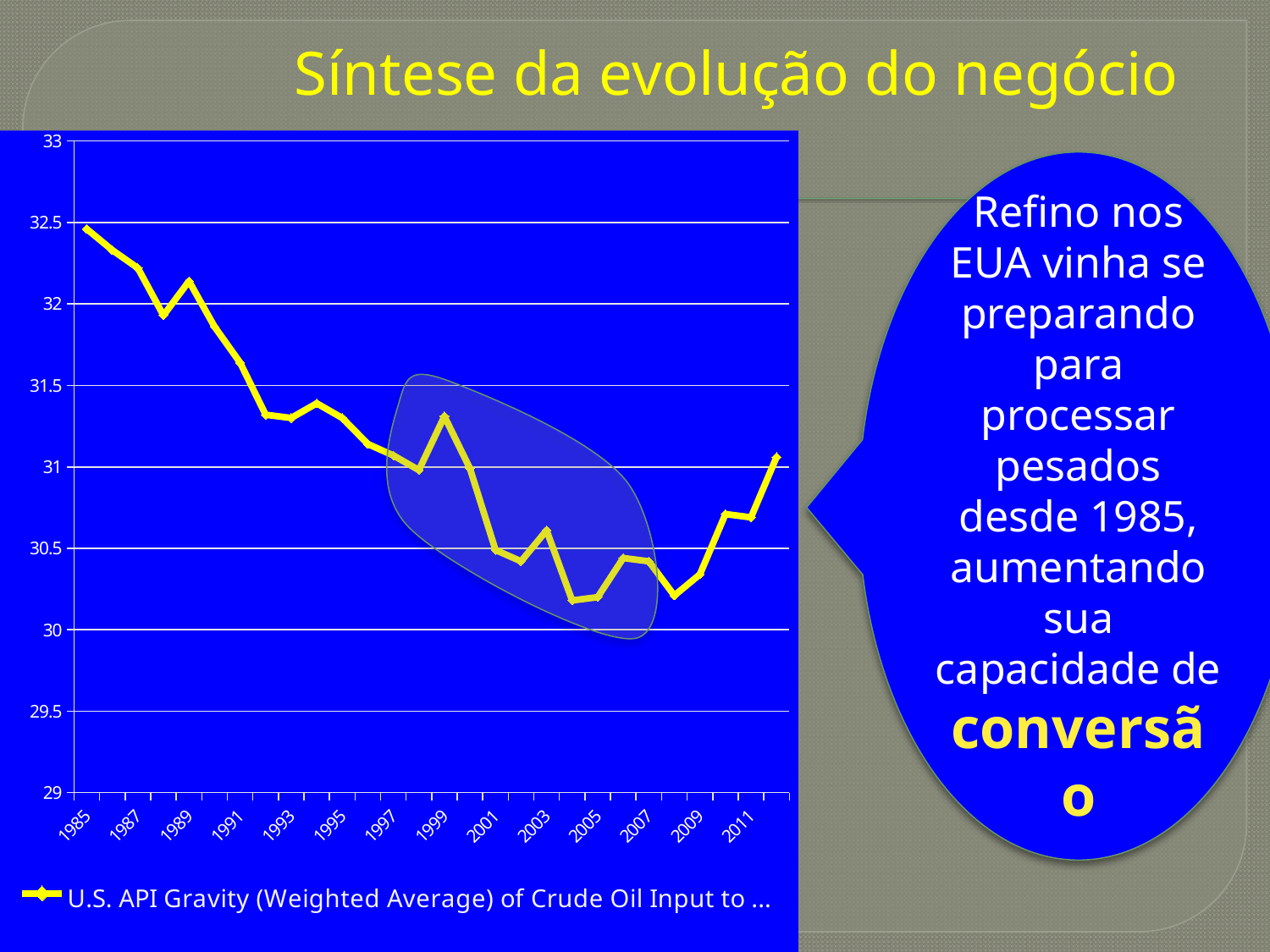
What colour is the plotted line? yellow Do the values generally rise or fall from 1985 to 2005? fall Is the value for 1999 greater or less than 31? greater How many series does the chart legend list? 1 Is the value for 1985 greater or less than 32? greater Which is larger, the value for 1985 or the value for 2011? 1985 Is the value for 2009 greater or less than 30.5? less What kind of chart is shown on the slide? line chart Which year has the highest value on the chart? 1985 Which is larger, the value for 1999 or the value for 2001? 1999 What is the legend entry for the plotted series? U.S. API Gravity (Weighted Average) of Crude Oil Input to ...